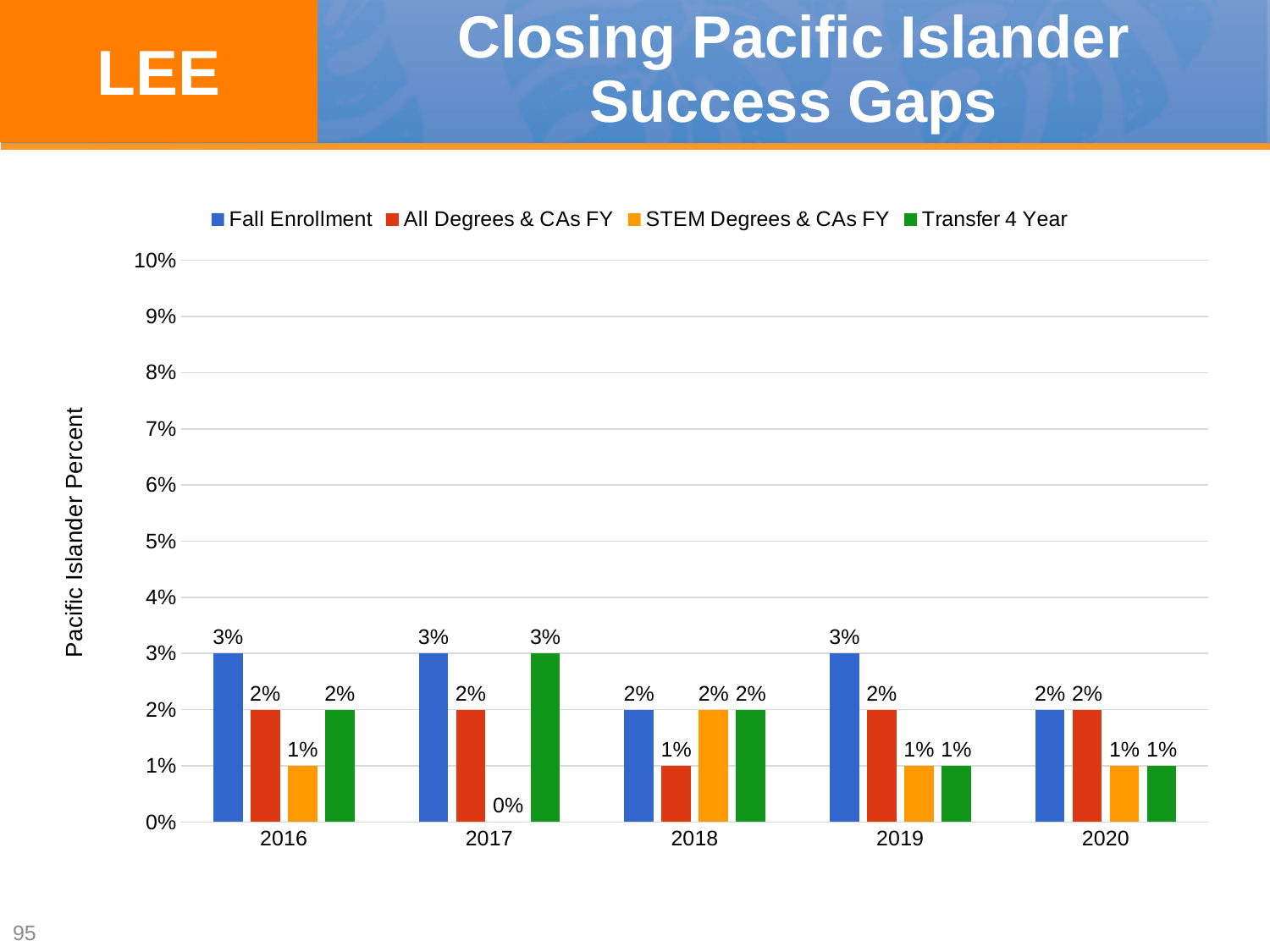
How many years are shown on the x axis? 5 What is the label on the vertical axis? Pacific Islander Percent Is the Fall Enrollment value for 2019 greater or less than 5%? less What is the STEM Degrees & CAs FY value for 2017? 0% What is the Transfer 4 Year value for 2020? 1% What kind of chart is shown on the slide? bar chart Which is larger, the Transfer 4 Year value for 2017 or for 2018? 2017 What is the difference between Fall Enrollment and STEM Degrees & CAs FY in 2017? 3% What is the Fall Enrollment value for 2016? 3% How many series does the legend list? 4 What is the Transfer 4 Year value for 2017? 3% What is the All Degrees & CAs FY value for 2018? 1%